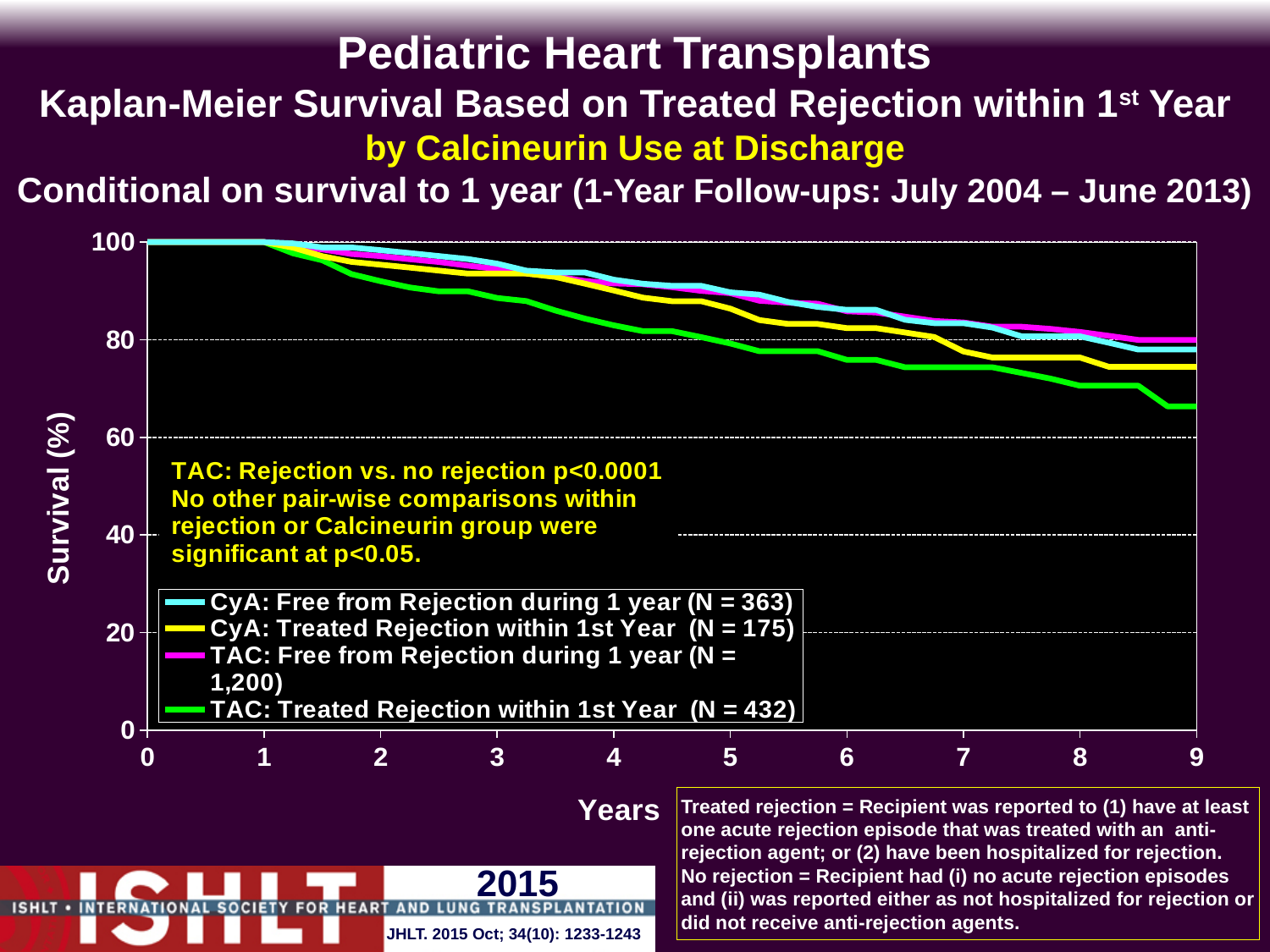
What is the N reported in the legend for TAC: Free from Rejection during 1 year? 1,200 What is the label of the y axis? Survival (%) Is the survival for TAC: Treated Rejection within 1st Year at year 3 greater or less than 80? greater What kind of chart is shown on the slide? line chart Is the survival for CyA: Treated Rejection within 1st Year at year 9 greater or less than 80? less At year 9, which is higher: CyA: Free from Rejection during 1 year or TAC: Treated Rejection within 1st Year? CyA: Free from Rejection during 1 year Is the survival for TAC: Treated Rejection within 1st Year at year 9 greater or less than 80? less How many series does the legend list? 4 Which series has the lowest survival at year 9? TAC: Treated Rejection within 1st Year Do the survival curves rise or fall as the years increase? fall At year 6, which is higher: CyA: Treated Rejection within 1st Year or TAC: Treated Rejection within 1st Year? CyA: Treated Rejection within 1st Year